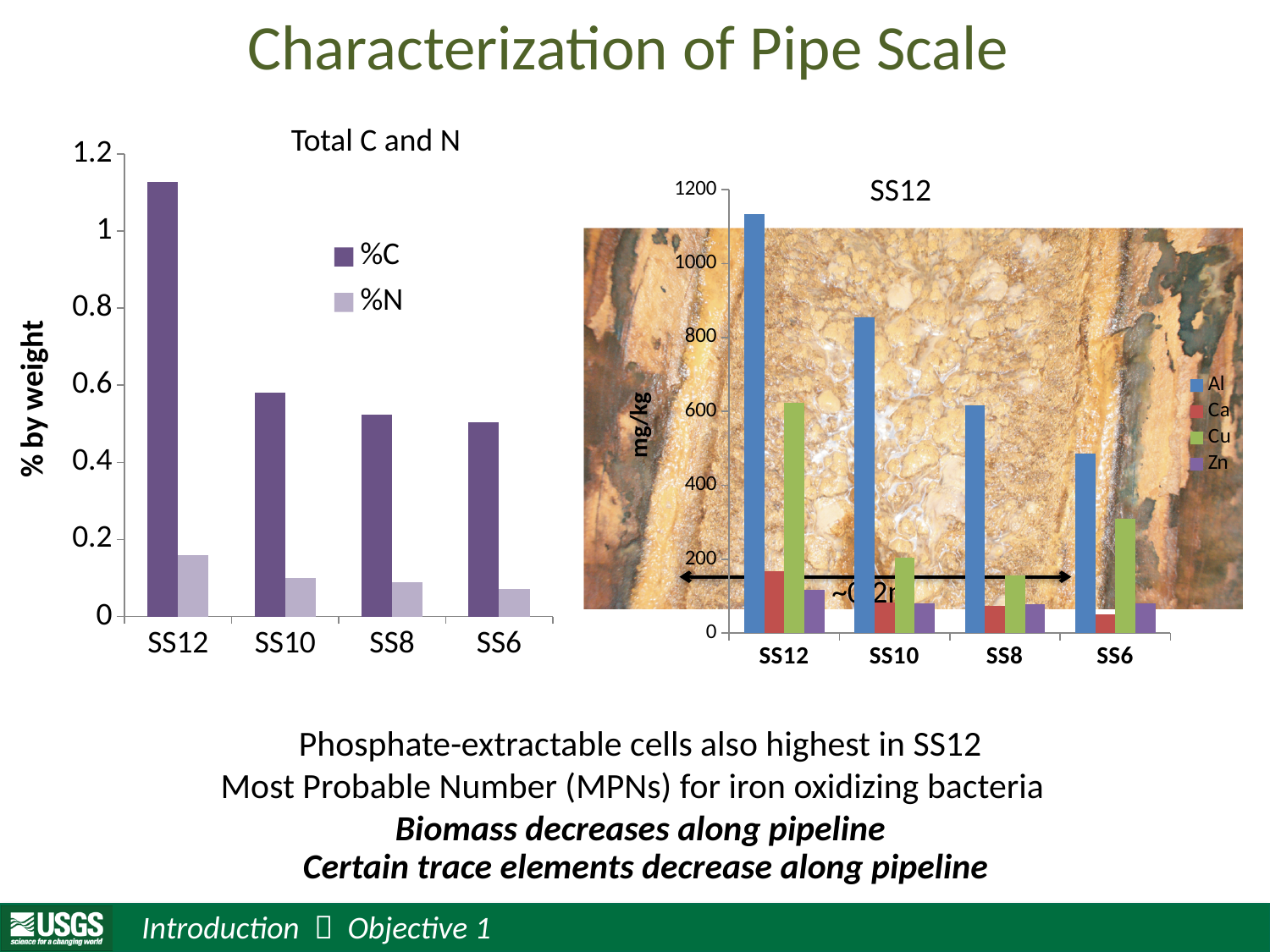
On the 'Total C and N' chart, is the %C value for SS10 greater or less than 0.8? less On the 'Total C and N' chart, what is the y-axis label? % by weight On the 'Total C and N' chart, what type of chart is shown? bar chart On the 'Total C and N' chart, do the %C values rise or fall from SS12 to SS6 along the x axis? fall On the right-hand chart titled 'SS12', which category has the highest Al value? SS12 On the right-hand chart titled 'SS12', how many series does the legend list? 4 On the 'Total C and N' chart, is the %C value for SS12 greater or less than 1? greater On the right-hand chart titled 'SS12', which is larger for SS12, Al or Cu? Al On the 'Total C and N' chart, how many series does the legend list? 2 On the 'Total C and N' chart, is the %N value for SS12 greater or less than 0.2? less On the 'Total C and N' chart, which category has the highest %C value? SS12